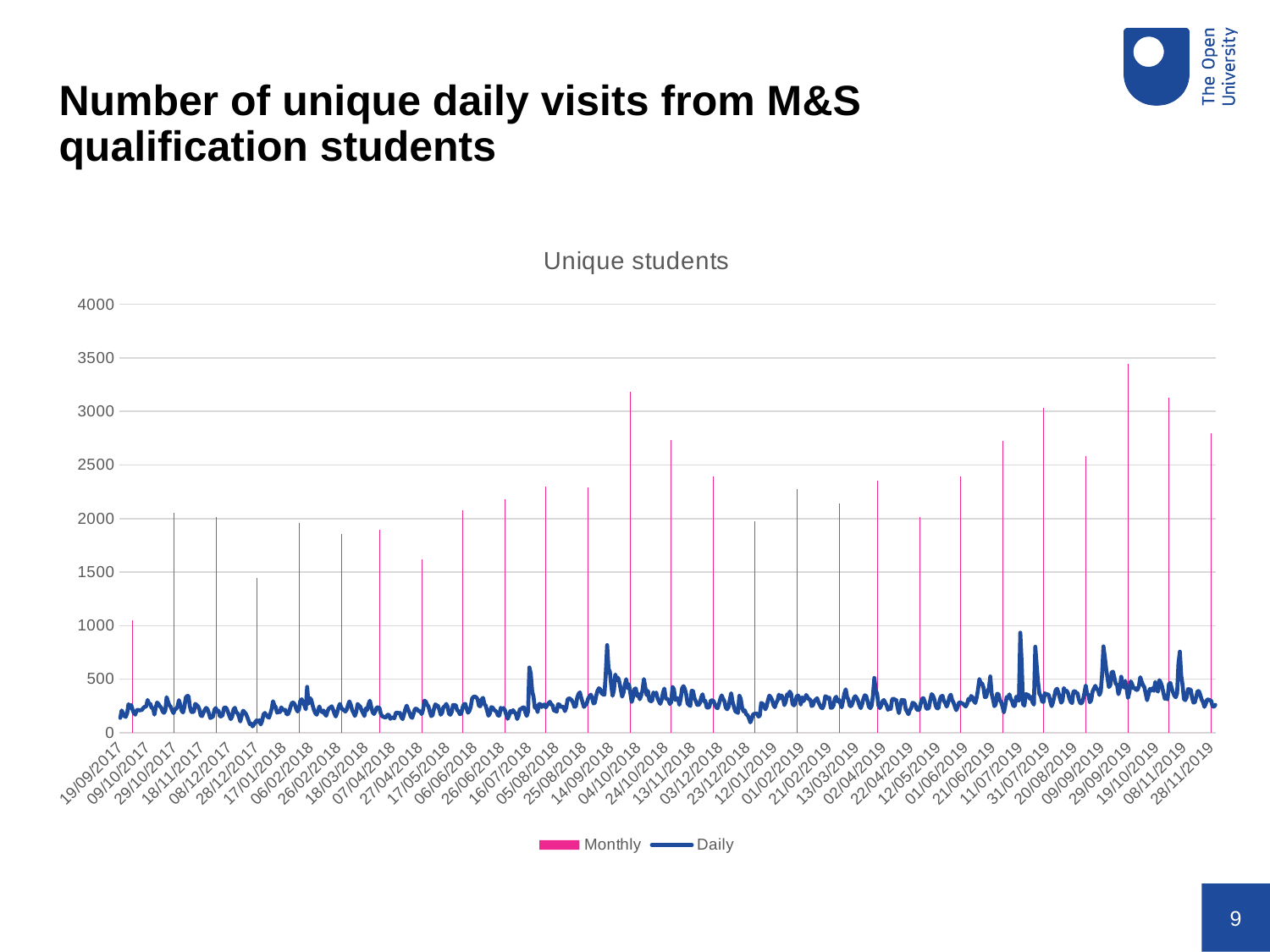
What kind of chart is shown on the slide? A combined bar and line chart Do the Monthly values generally rise or fall from 2017 to 2019? rise Is the highest point of the Daily line greater or less than 1000? less Is the tallest Monthly bar greater or less than 3000? greater Which Monthly bar is the lowest? The first one What are the two series named in the legend? Monthly and Daily What is the title shown above the chart? Unique students Is the first Monthly bar (19/09/2017) greater or less than 1500? less Is the last Monthly bar (28/11/2019) larger or smaller than the first Monthly bar (19/09/2017)? larger In which year does the tallest Monthly bar occur? 2019 How many series does the legend list? 2 What is the highest value shown on the vertical axis? 4000